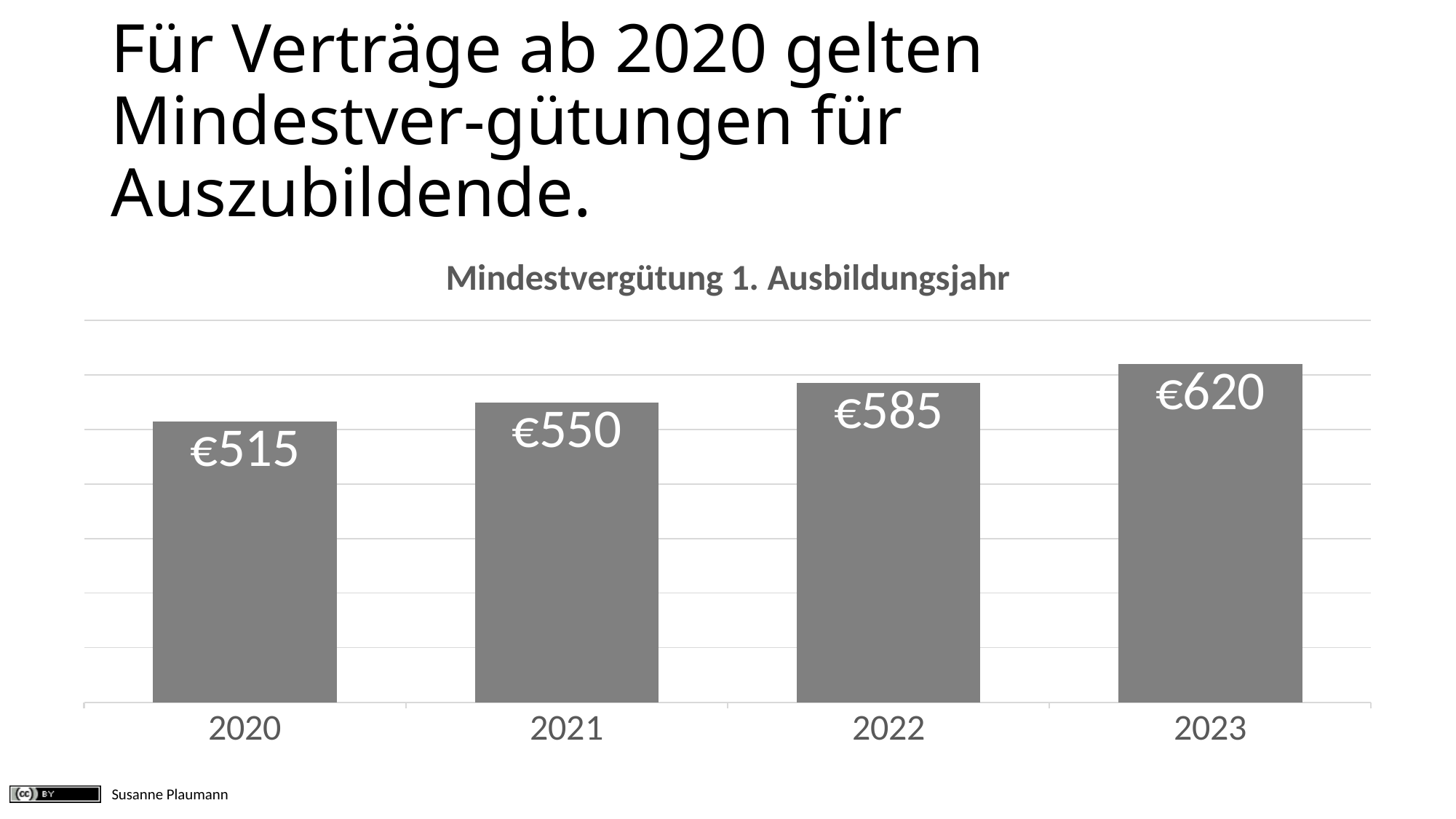
Do the values rise or fall from 2020 to 2023? Rise Which year has the lowest minimum remuneration? 2020 Which year has the highest minimum remuneration? 2023 What is the minimum remuneration shown for 2020? €515 What is the value shown for 2021? €550 What is the value shown for 2023? €620 Which is larger, the value for 2021 or the value for 2022? 2022 How many years are shown on the x axis? 4 What is the value shown for 2022? €585 What is the difference between the values for 2023 and 2020? €105 What is the difference between the values for 2022 and 2021? €35 What kind of chart is shown? Bar chart